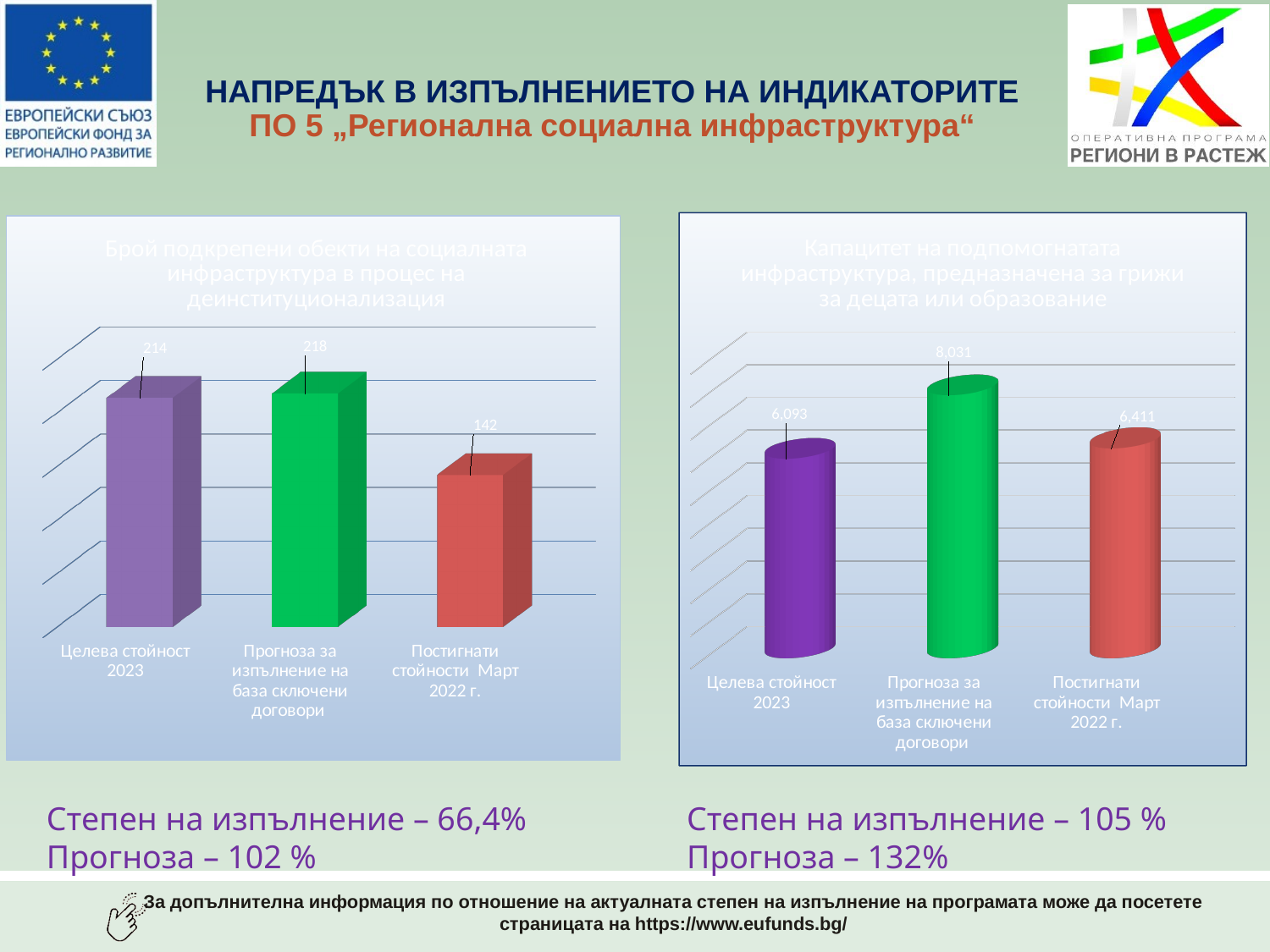
In the left chart, what is the value for "Постигнати стойности Март 2022 г."? 142 In the left chart, which category has the lowest value? Постигнати стойности Март 2022 г. In the left chart, what is the value for "Целева стойност 2023"? 214 In the right chart, which is larger: the value for "Постигнати стойности Март 2022 г." or the value for "Целева стойност 2023"? Постигнати стойности Март 2022 г. In the right chart, what is the difference between the value for "Прогноза за изпълнение на база сключени договори" and the value for "Постигнати стойности Март 2022 г."? 1,620 What type of chart is the right chart? Bar chart In the right chart, what is the value for "Прогноза за изпълнение на база сключени договори"? 8,031 In the right chart, which category has the lowest value? Целева стойност 2023 How many categories are shown in the left chart? 3 In the left chart, which category has the highest value? Прогноза за изпълнение на база сключени договори In the right chart, what is the value for "Целева стойност 2023"? 6,093 In the left chart, what is the difference between the value for "Целева стойност 2023" and the value for "Постигнати стойности Март 2022 г."? 72